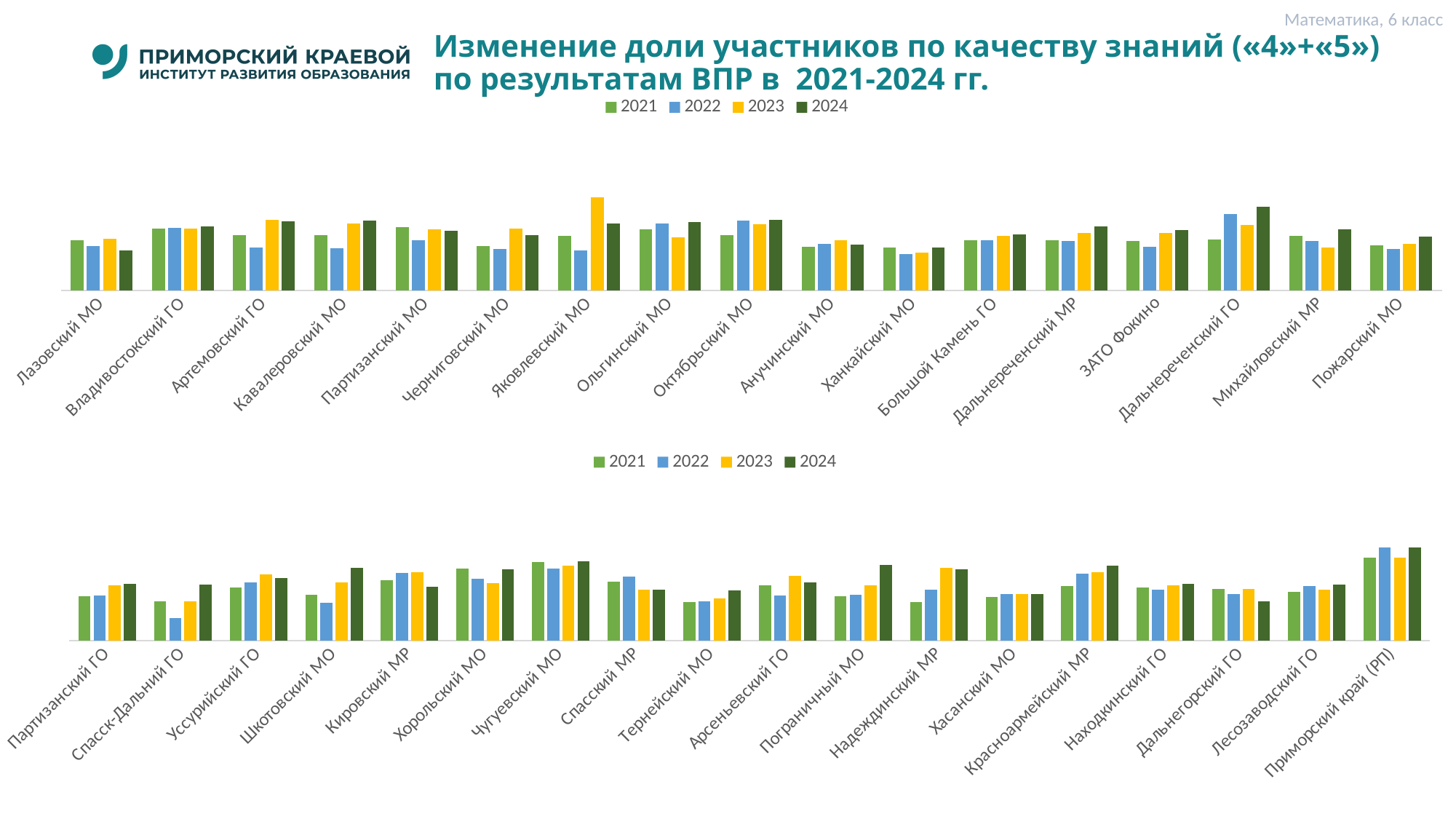
In the top chart, for Лазовский МО, which is larger: the 2021 bar or the 2024 bar? 2021 In the top chart, which year has the highest bar for Яковлевский МО? 2023 Which colour represents the 2023 series in the legend? yellow How many series does the legend of the top chart list? 4 In the bottom chart, which category has the lowest bar overall? Спасск-Дальний ГО In the top chart, which year has the highest bar for Дальнереченский ГО? 2024 How many categories (municipalities) are shown on the x axis of the top chart? 17 What kind of chart is the top chart on the slide? bar chart How many categories are shown on the x axis of the bottom chart? 18 In the top chart, which category has the tallest bar overall? Яковлевский МО In the bottom chart, which year has the lowest bar for Спасск-Дальний ГО? 2022